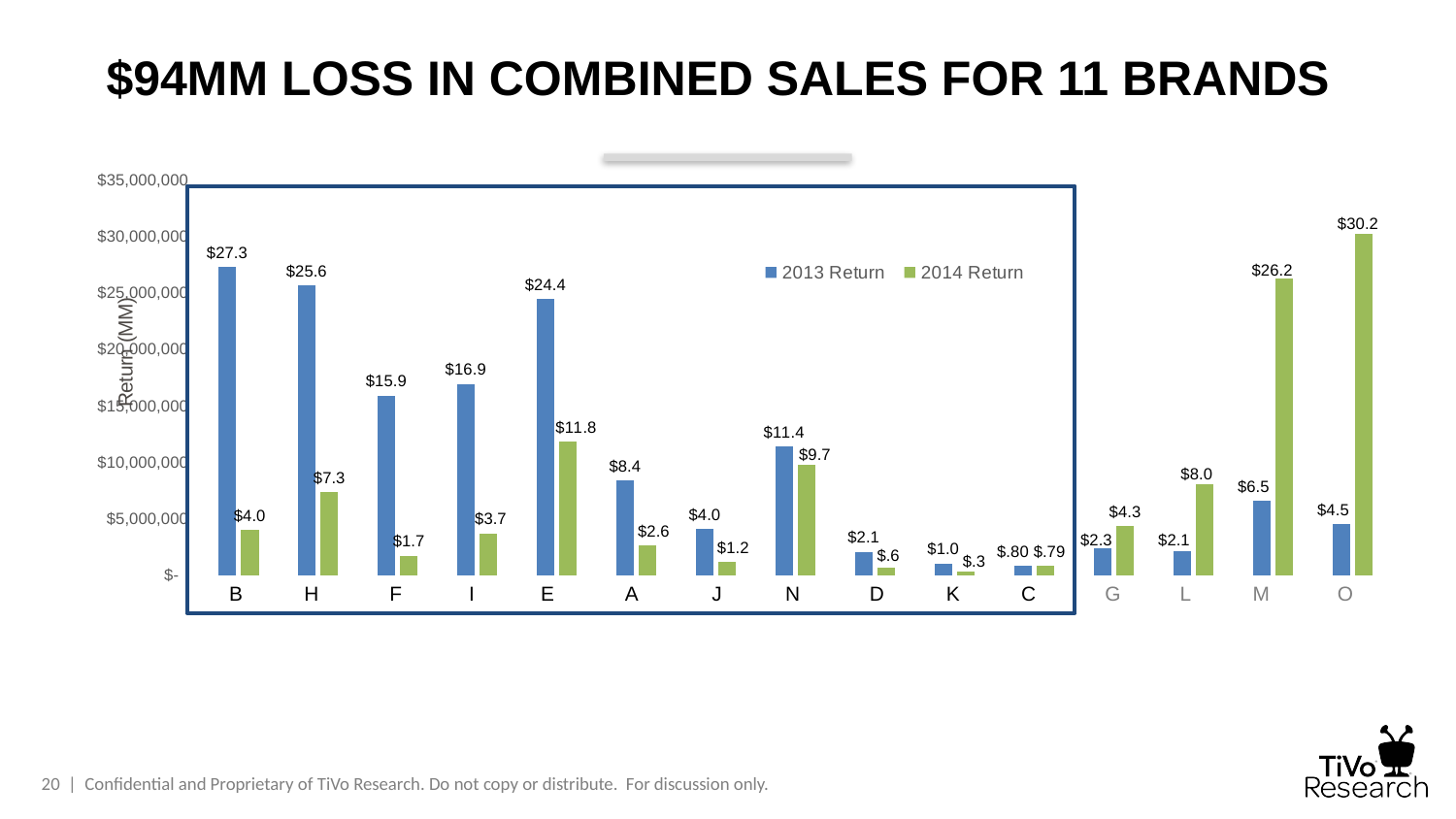
What kind of chart is shown on the slide? Bar chart What is the 2014 Return value for brand E? $11.8 What is the label on the vertical axis of the chart? Return (MM) Which brand has the highest 2014 Return? O What is the difference between the 2013 Return and the 2014 Return for brand H? $18.3 Which brand has the lowest 2013 Return? C How many series does the legend list? 2 What is the 2014 Return value for brand M? $26.2 Which brand has the highest 2013 Return? B Which is larger for brand L, the 2013 Return or the 2014 Return? 2014 Return What is the 2013 Return value for brand B? $27.3 How many brands are shown on the x axis of the chart? 15